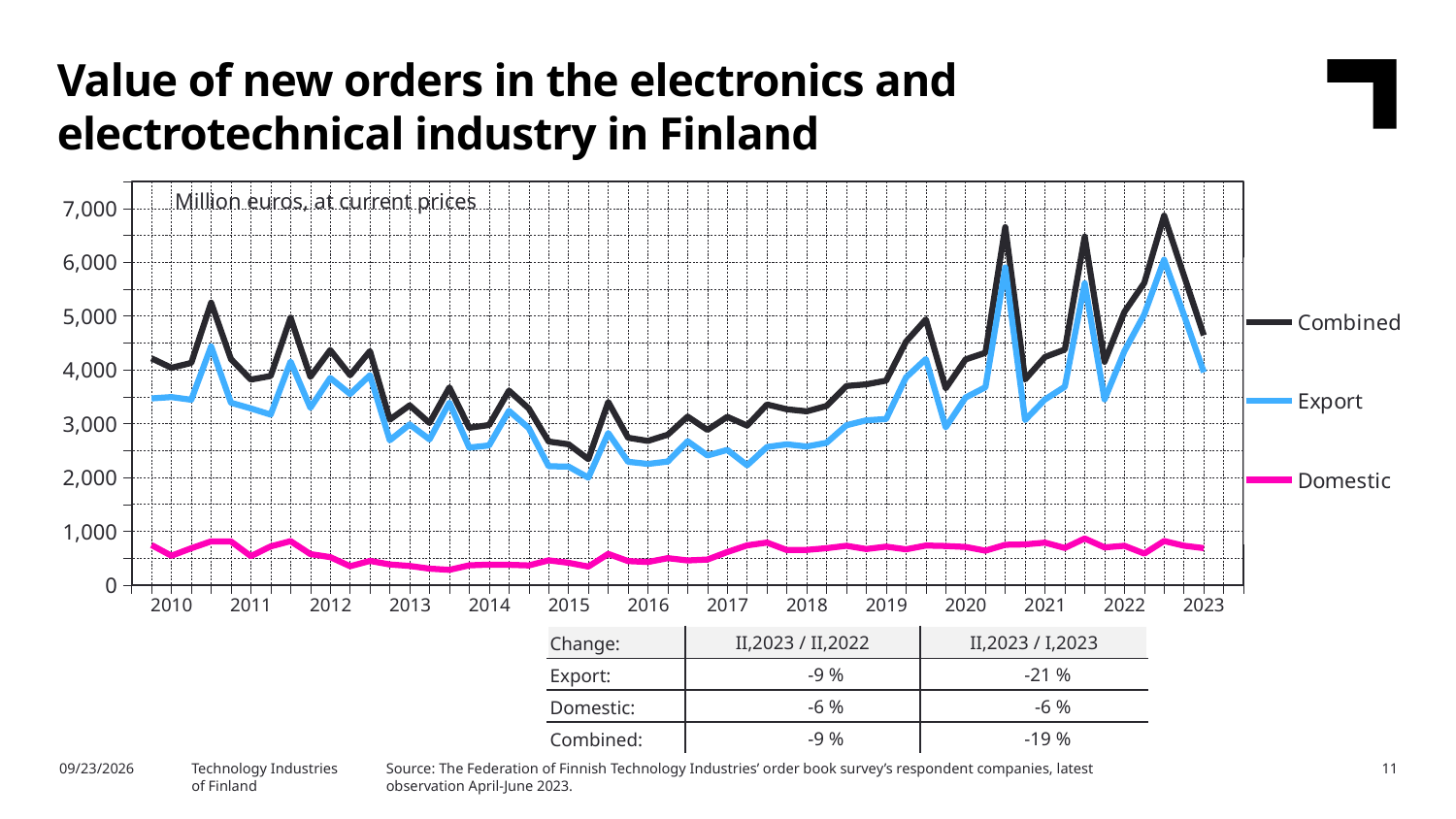
Which series has the lowest values across the whole chart? Domestic In 2020, which is larger, the Export value or the Domestic value? Export What kind of chart is shown on the slide? Line chart Does the Combined series generally rise or fall between 2015 and 2022? rise Is the Domestic value in 2015 greater or less than 1,000? less How many series does the chart's legend list? 3 What unit label is printed inside the chart area? Million euros, at current prices What are the three series named in the chart's legend? Combined, Export, Domestic Is the peak Combined value in 2022 greater or less than 6,000? greater How many year labels are shown on the x axis? 14 Which series has the highest values across the whole chart? Combined Is the Export value in 2015 greater or less than 3,000? less